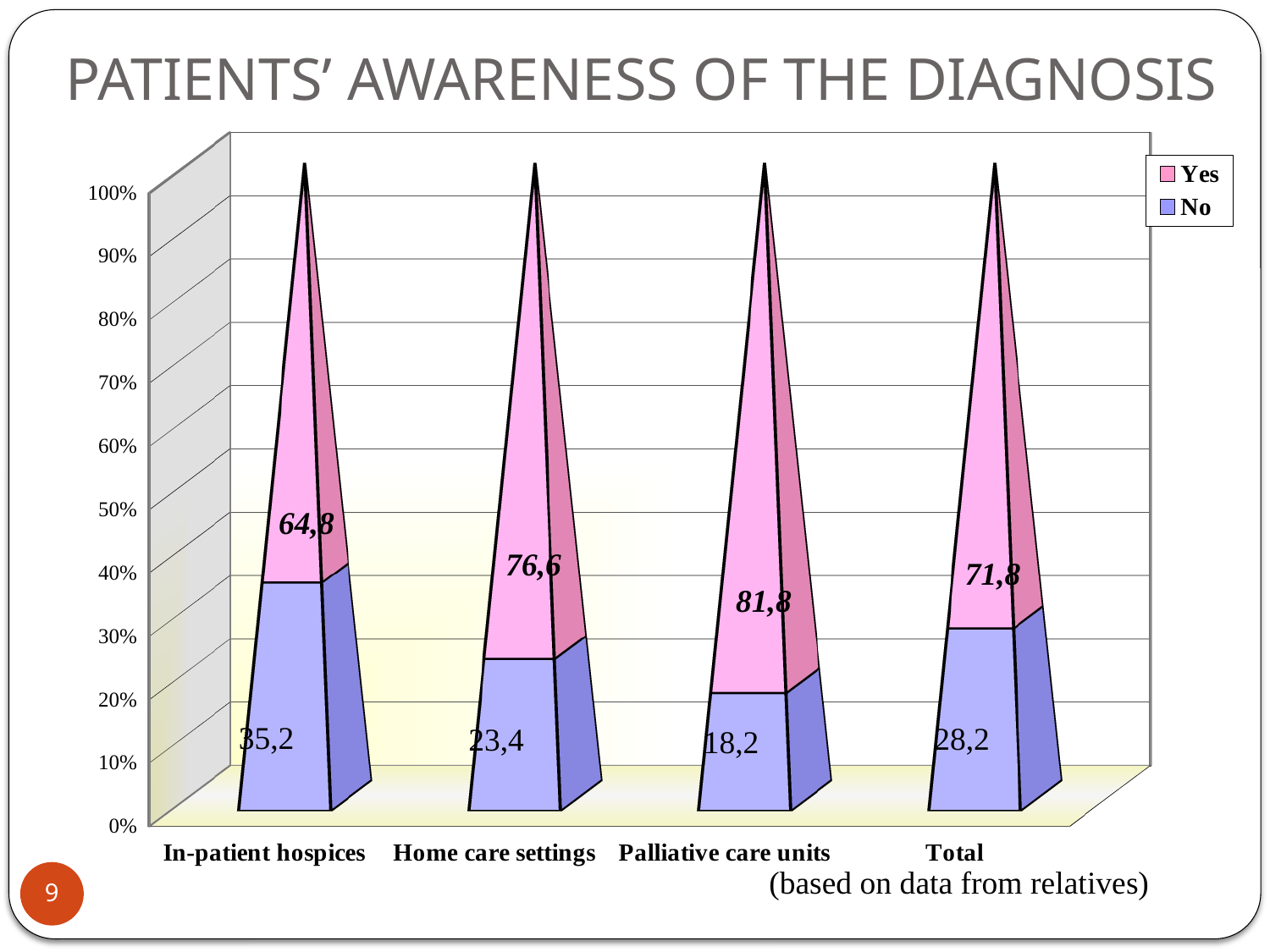
How many series does the legend list? 2 How many categories are shown on the x axis? 4 Which colour represents the 'Yes' series in the legend? Pink What is the 'Yes' value for Total? 71,8 What kind of chart is shown on the slide? Stacked bar chart Which is larger: the 'No' value for In-patient hospices or the 'No' value for Total? In-patient hospices What is the 'No' value for In-patient hospices? 35,2 Which category has the highest 'Yes' value? Palliative care units Which category has the lowest 'No' value? Palliative care units What is the difference between the 'Yes' values for Home care settings and In-patient hospices? 11,8 What is the 'Yes' value for Palliative care units? 81,8 What is the 'No' value for Home care settings? 23,4